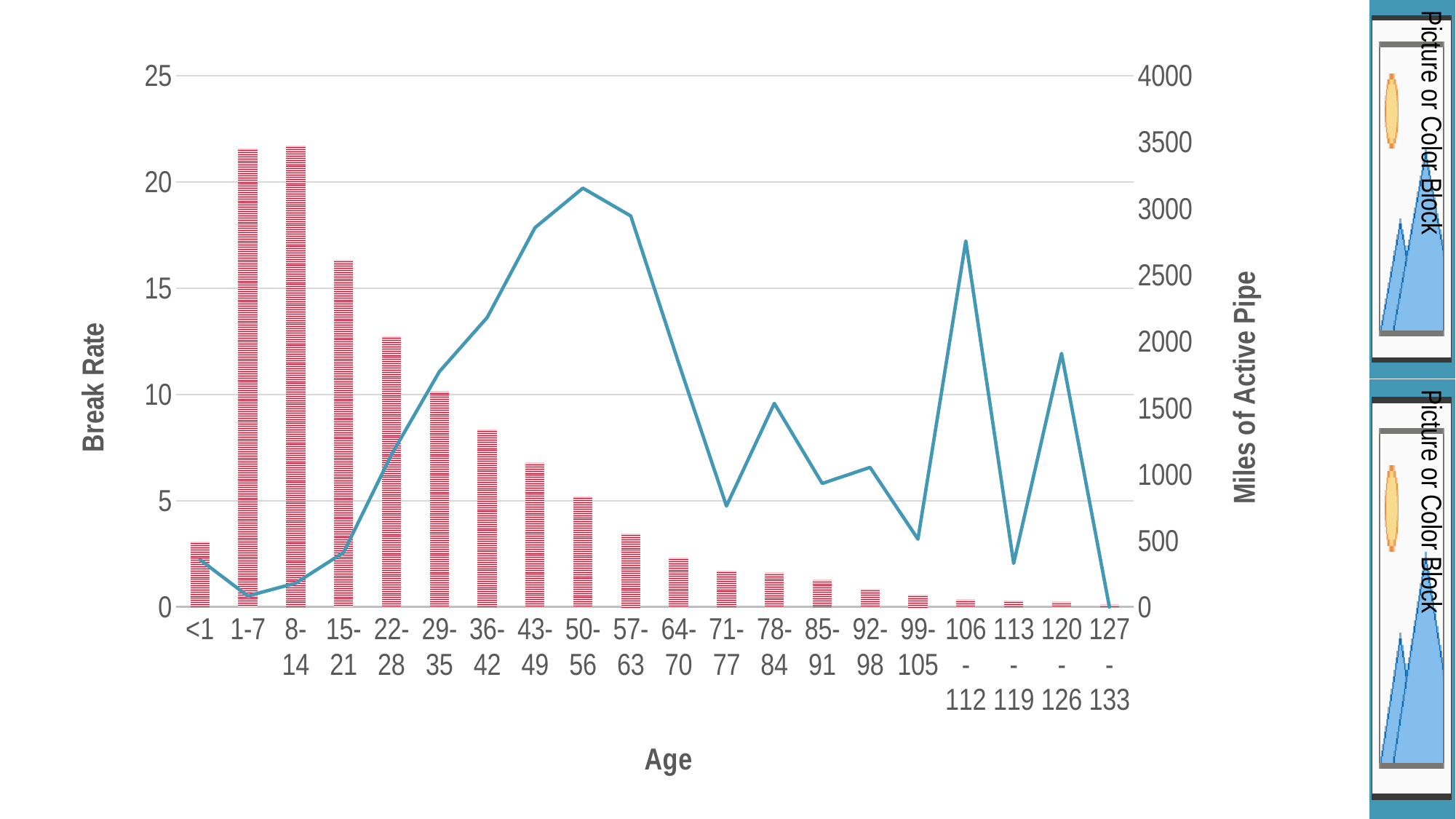
How many age categories are shown on the x axis? 20 What is the title of the left vertical axis? Break Rate Is the Miles of Active Pipe value for age 71-77 greater or less than 1000? less What is the title of the right vertical axis? Miles of Active Pipe What kind of chart is shown on the slide? A combination bar and line chart Is the Miles of Active Pipe value for age 50-56 greater or less than 3000? less